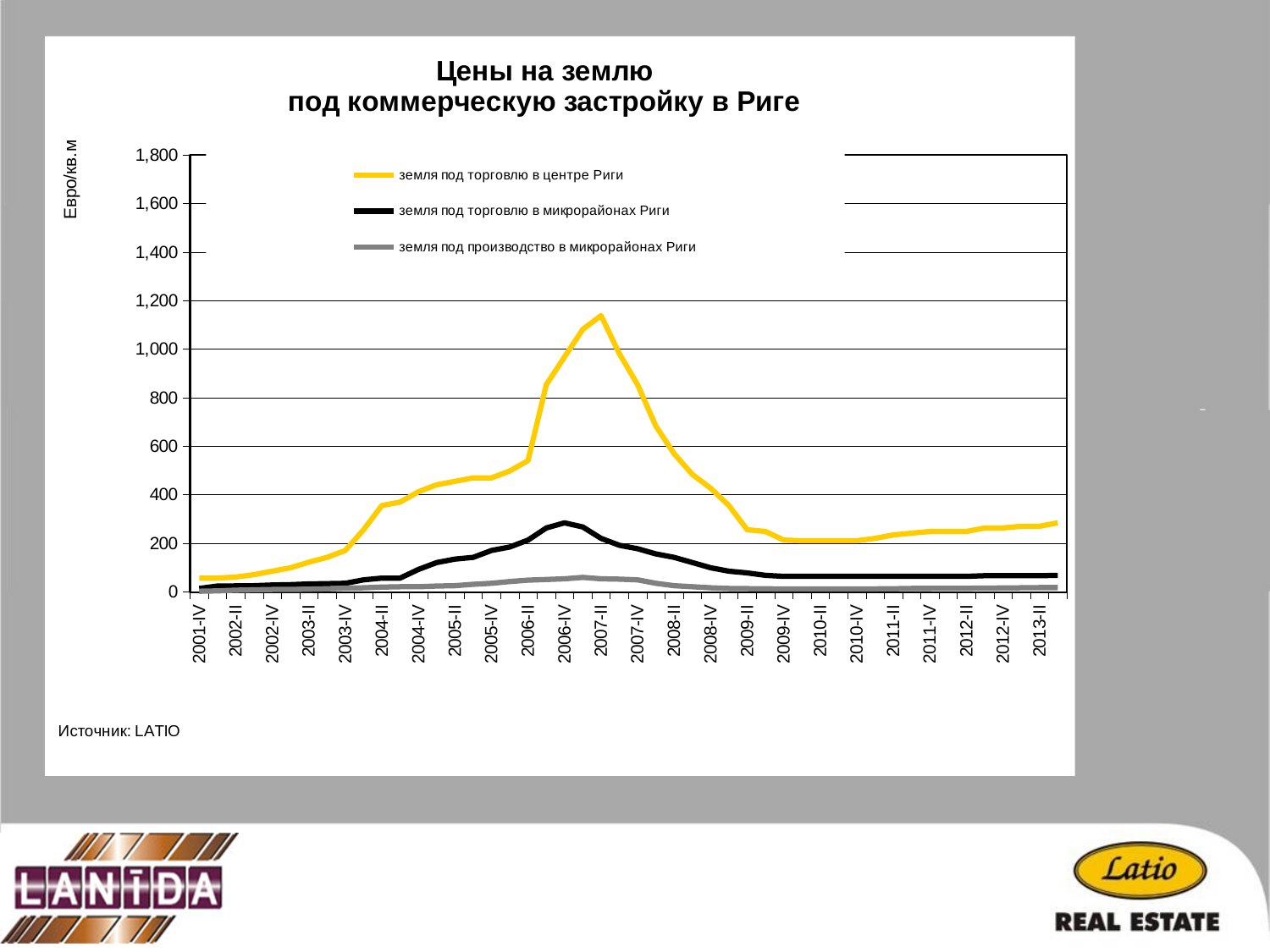
Does the value for 'земля под торговлю в центре Риги' rise or fall between 2007-II and 2009-IV? fall Which series reaches the highest value on the chart? земля под торговлю в центре Риги Is the value for 'земля под торговлю в центре Риги' at 2013-II greater or less than 400? less Which series has the lowest values throughout the chart? земля под производство в микрорайонах Риги What kind of chart is shown on the slide? Line chart How many series does the legend list? 3 At 2007-II, which series has the larger value: 'земля под торговлю в центре Риги' or 'земля под торговлю в микрорайонах Риги'? земля под торговлю в центре Риги Which series is drawn in yellow according to the legend? земля под торговлю в центре Риги Is the value for 'земля под торговлю в центре Риги' at 2001-IV greater or less than 200? less Is the value for 'земля под торговлю в центре Риги' at 2007-II greater or less than 1,000? greater What is the title of the chart? Цены на землю под коммерческую застройку в Риге